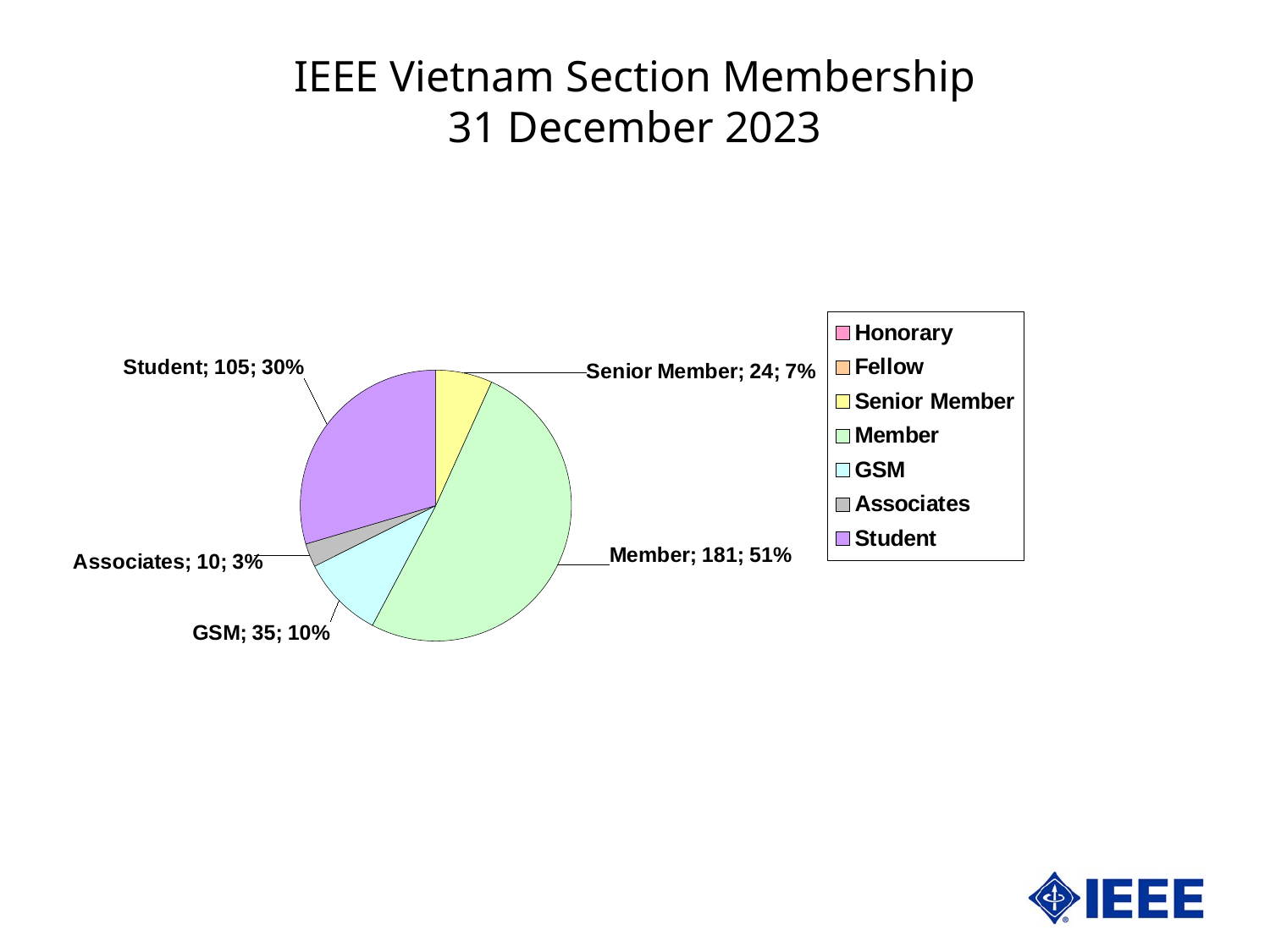
What is the value for GSM? 35 What share of the pie does the Member slice represent? 51% What is the difference between the Member value and the Student value? 76 How many members are in the Member category? 181 Which category has the largest slice of the pie? Member Which labelled category has the smallest slice of the pie? Associates How many members are in the Student category? 105 How many entries does the legend list? 7 What is the value for Senior Member? 24 What share of the pie does the Student slice represent? 30% Which is larger, the GSM value or the Senior Member value? GSM What type of chart is shown on the slide? pie chart